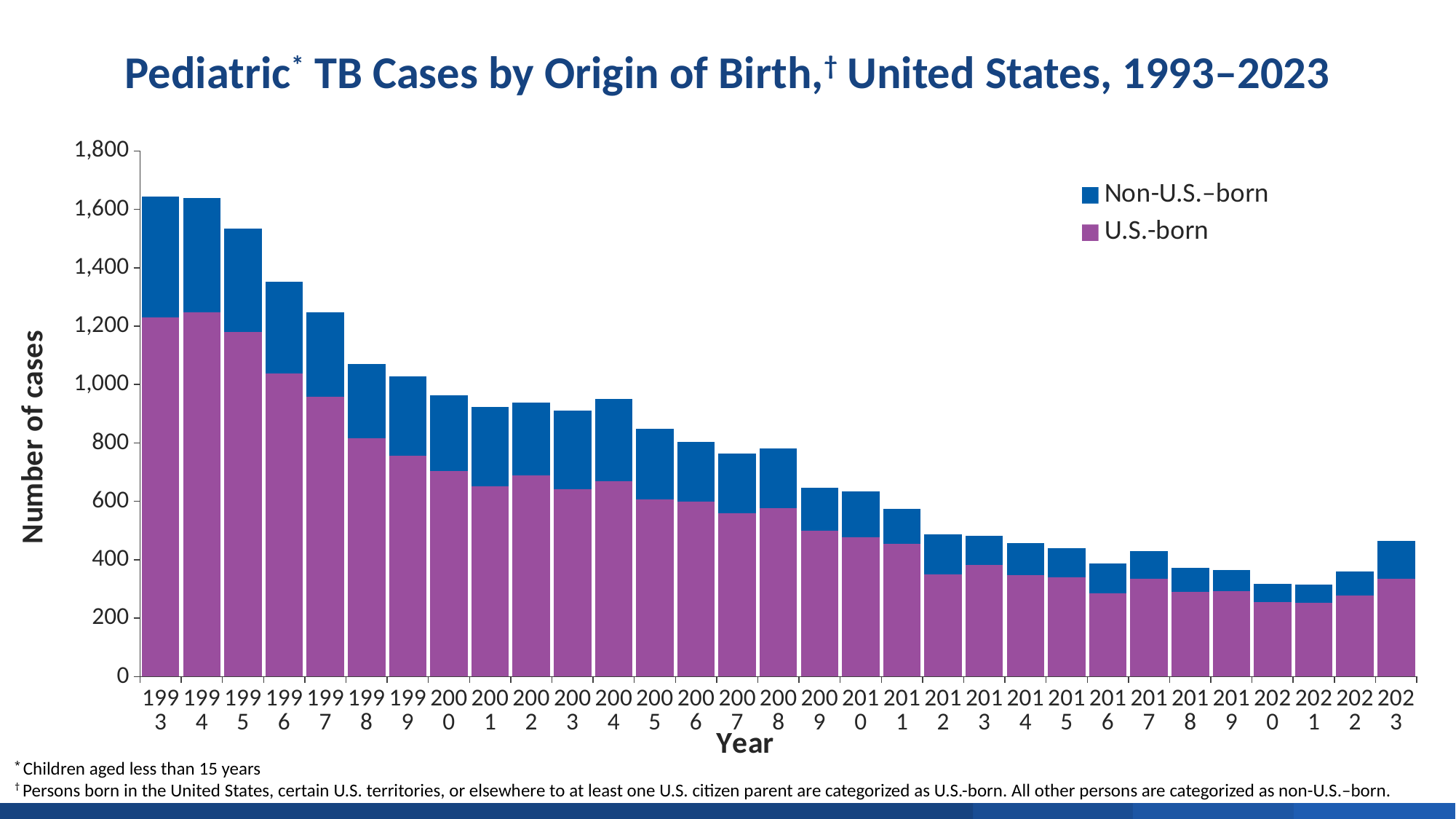
Is the total number of cases for 2023 greater or less than 400? greater Which series is shown in purple? U.S.-born Is the total number of cases for 1993 greater or less than 1,600? greater Do the total number of cases generally rise or fall from 1993 to 2021? fall Is the total number of cases for 1996 greater or less than 1,200? greater How many series does the legend list? 2 Which year has the larger total number of cases, 1993 or 2023? 1993 How many years are shown along the x axis? 31 What kind of chart is shown on the slide? Stacked bar chart Which year has the larger total number of cases, 2022 or 2023? 2023